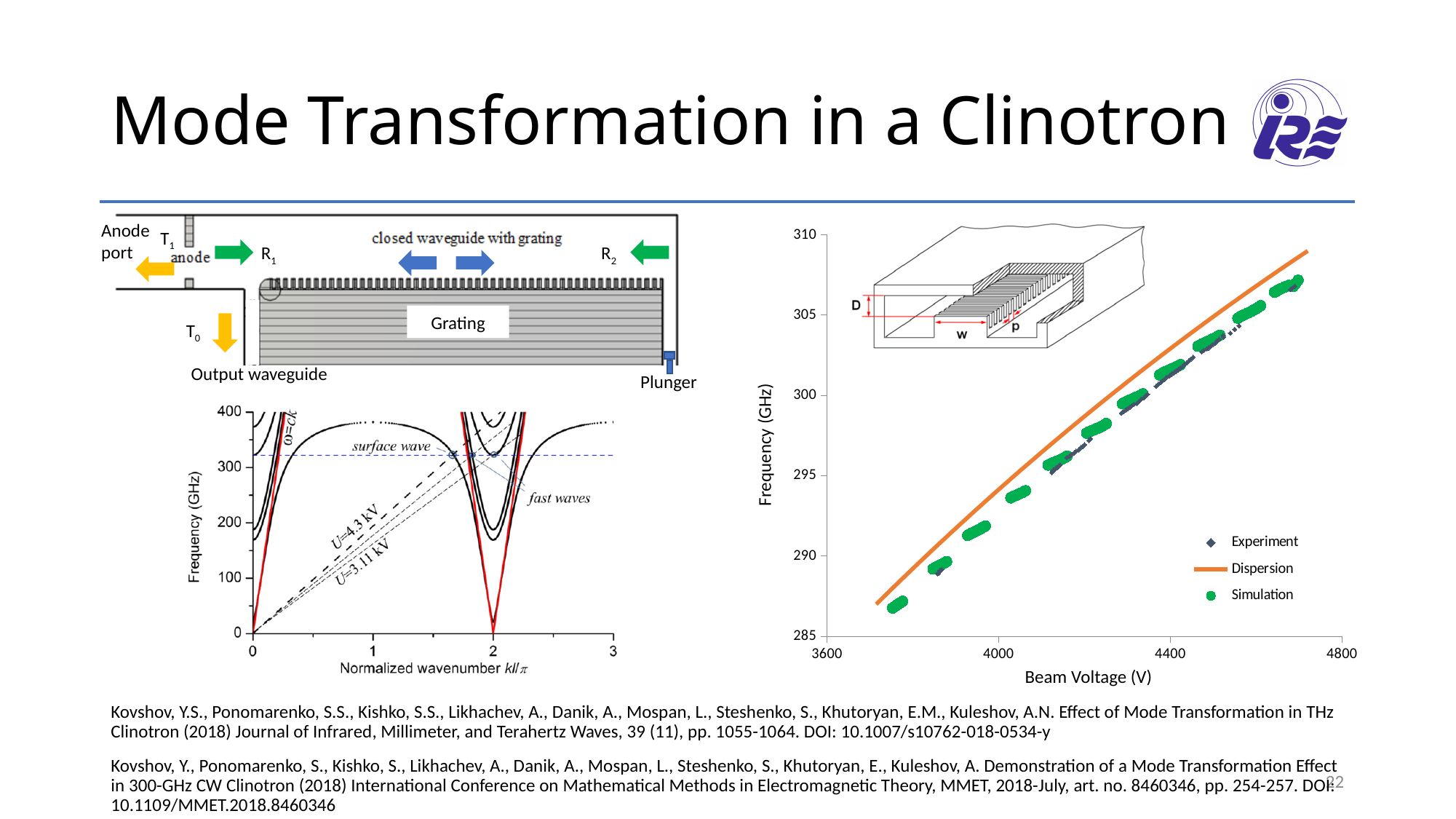
On the right-hand chart, what are the three legend entries? Experiment, Dispersion, Simulation On the right-hand chart, what is the highest tick value shown on the Beam Voltage axis? 4800 On the right-hand chart, what colour is the Dispersion series drawn in? orange On the lower-left chart, what is the label of the x axis? Normalized wavenumber kl/π On the right-hand chart, is the Simulation value at the highest plotted beam voltage (around 4700 V) greater or less than 305 GHz? greater On the right-hand chart, does frequency rise or fall as beam voltage increases? rise On the lower-left chart, what is the maximum value shown on the Frequency (GHz) axis? 400 On the right-hand chart, is the Dispersion curve at 4400 V greater or less than 300 GHz? greater On the right-hand chart, which lies higher at 4000 V, the Dispersion curve or the Simulation points? Dispersion On the right-hand chart (Frequency vs Beam Voltage), how many series does the legend list? 3 On the right-hand chart, is the Simulation value at the lowest plotted beam voltage (around 3760 V) greater or less than 290 GHz? less